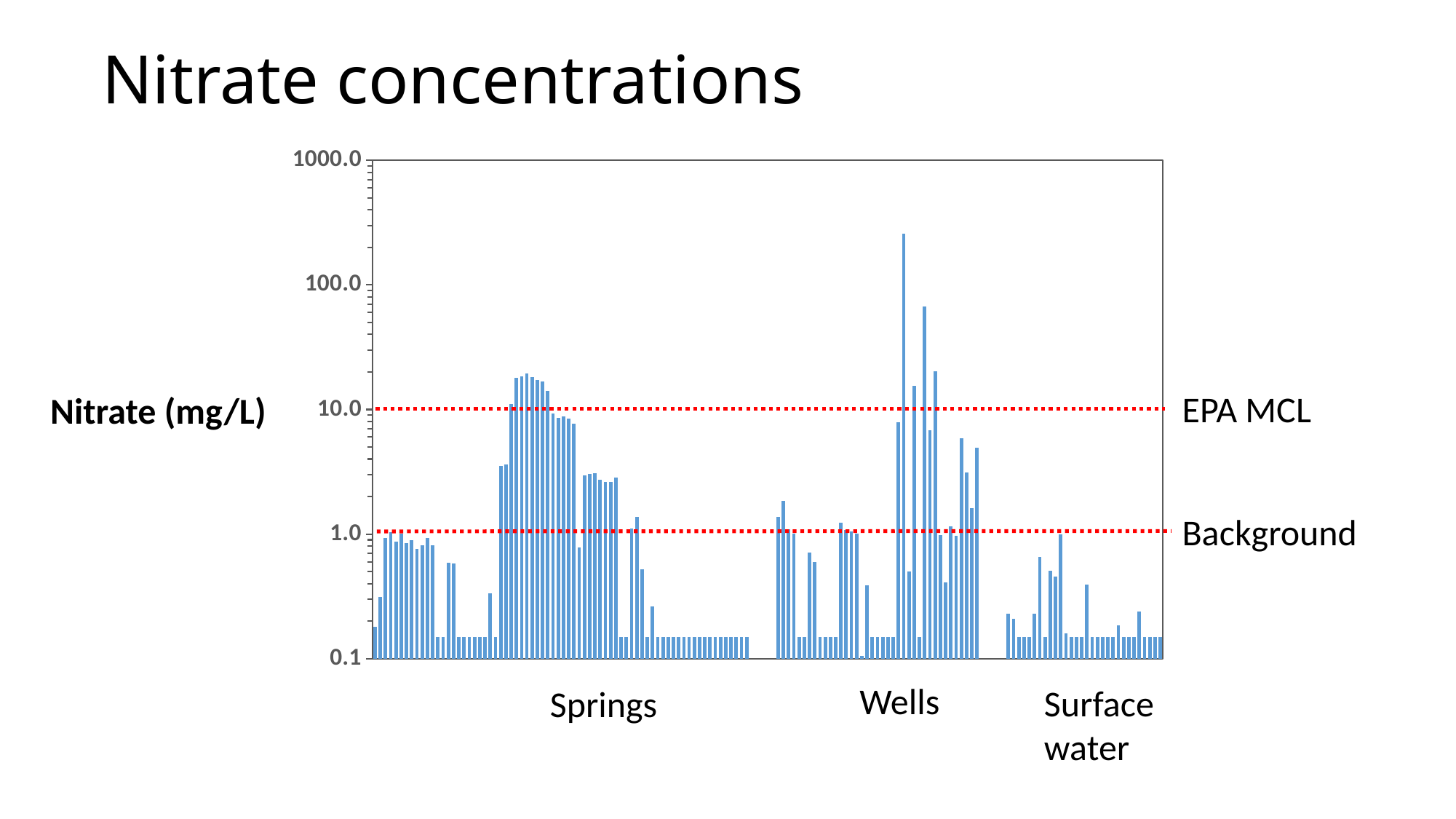
Which group has the higher maximum value, Springs or Surface water? Springs At what nitrate concentration is the Background reference line drawn? 1.0 Which sample group contains the tallest bar in the chart? Wells Is the tallest bar in the Springs group greater or less than 100.0 mg/L? less At what nitrate concentration is the EPA MCL reference line drawn? 10.0 Is the tallest bar in the Wells group greater or less than 100.0 mg/L? greater What kind of chart is shown on the slide? bar chart How many sample groups are labelled along the bottom of the chart? 3 What is the label of the vertical axis of the chart? Nitrate (mg/L) What is the title of the chart on the slide? Nitrate concentrations What is the highest value shown on the vertical axis of the chart? 1000.0 Is the tallest bar in the Surface water group greater or less than 10.0 mg/L? less